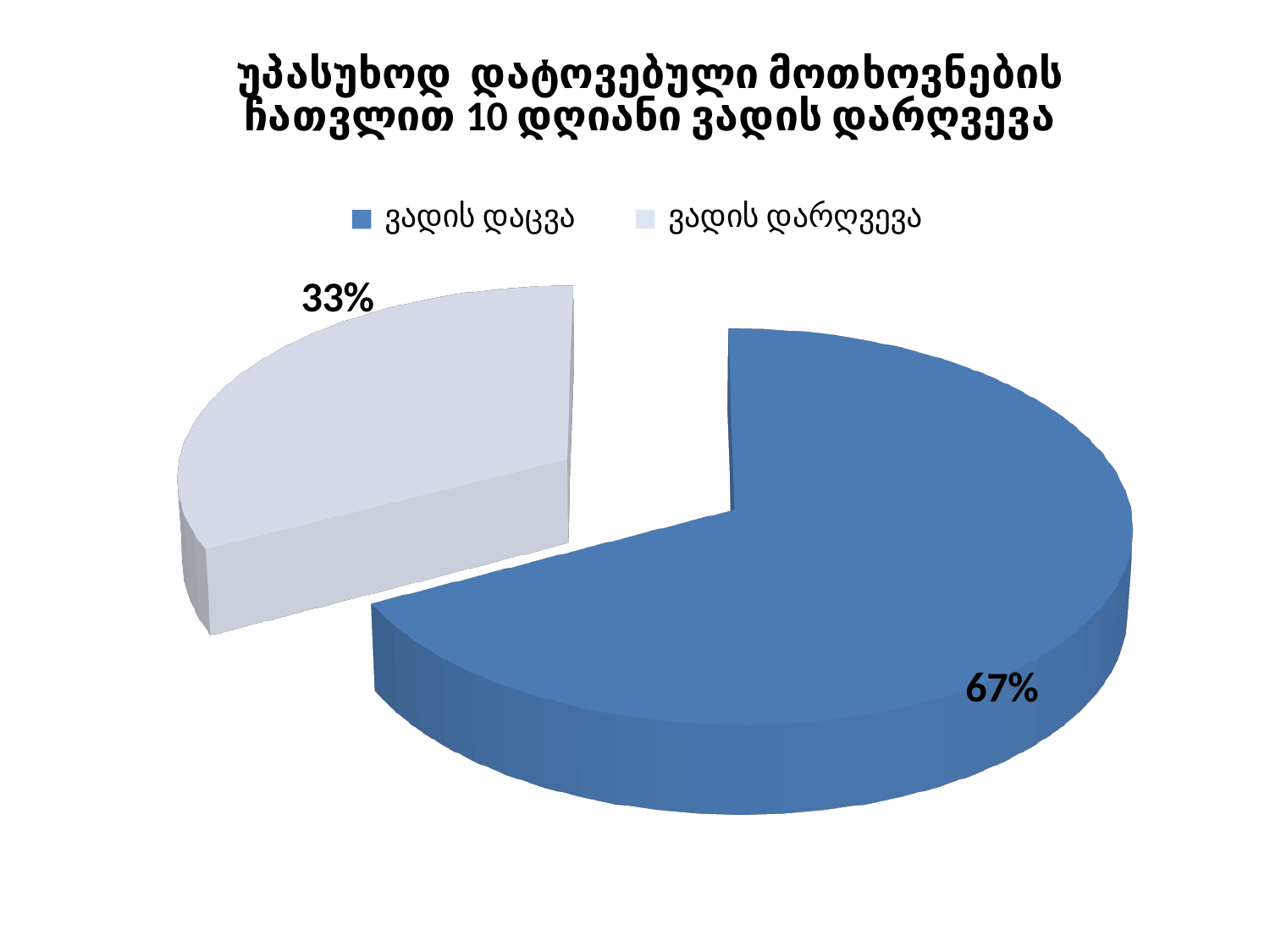
What share of the pie does ვადის დარღვევა represent? 33% Which legend entry is shown in the light colour? ვადის დარღვევა Which is larger, the ვადის დაცვა slice or the ვადის დარღვევა slice? ვადის დაცვა What kind of chart is shown on the slide? Pie chart What is the difference in percentage points between the ვადის დაცვა slice and the ვადის დარღვევა slice? 34 How many entries does the legend list? 2 What colour is the ვადის დაცვა slice? Blue Which slice is the smallest in the pie chart? ვადის დარღვევა Which slice is the largest in the pie chart? ვადის დაცვა What share of the pie does ვადის დაცვა represent? 67% How many slices does the pie chart have? 2